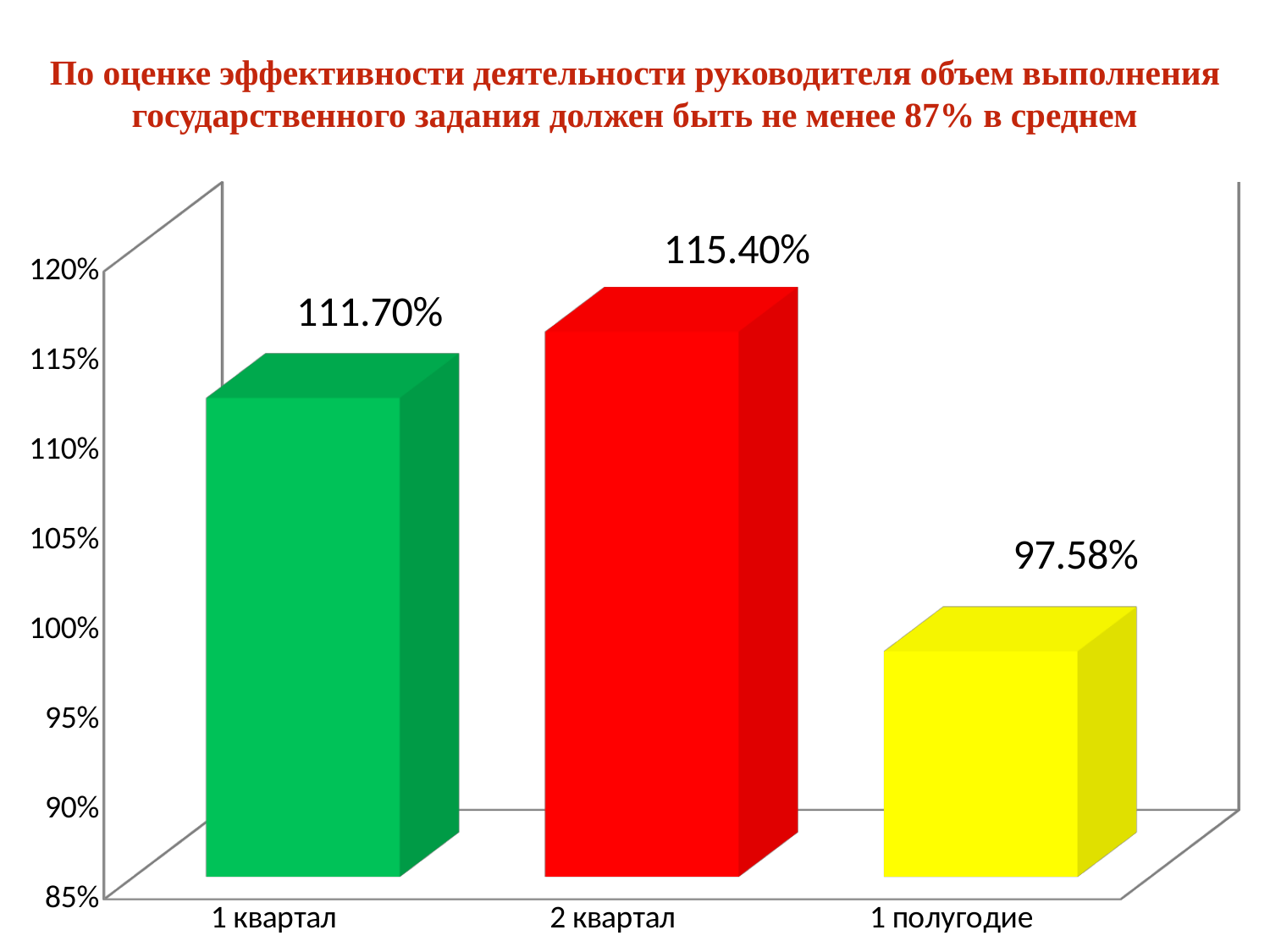
What is the value for 1 квартал? 111.70% What is the difference between the values for 1 квартал and 1 полугодие? 14.12% What colour is the bar for 2 квартал? red Is the value for 1 полугодие greater or less than 100%? less Which is larger, the value for 1 квартал or the value for 1 полугодие? 1 квартал What is the difference between the values for 2 квартал and 1 квартал? 3.70% Which category has the lowest value? 1 полугодие What kind of chart is shown on the slide? bar chart Which category has the highest value? 2 квартал What is the value for 2 квартал? 115.40% What is the value for 1 полугодие? 97.58% How many categories are shown on the x axis? 3